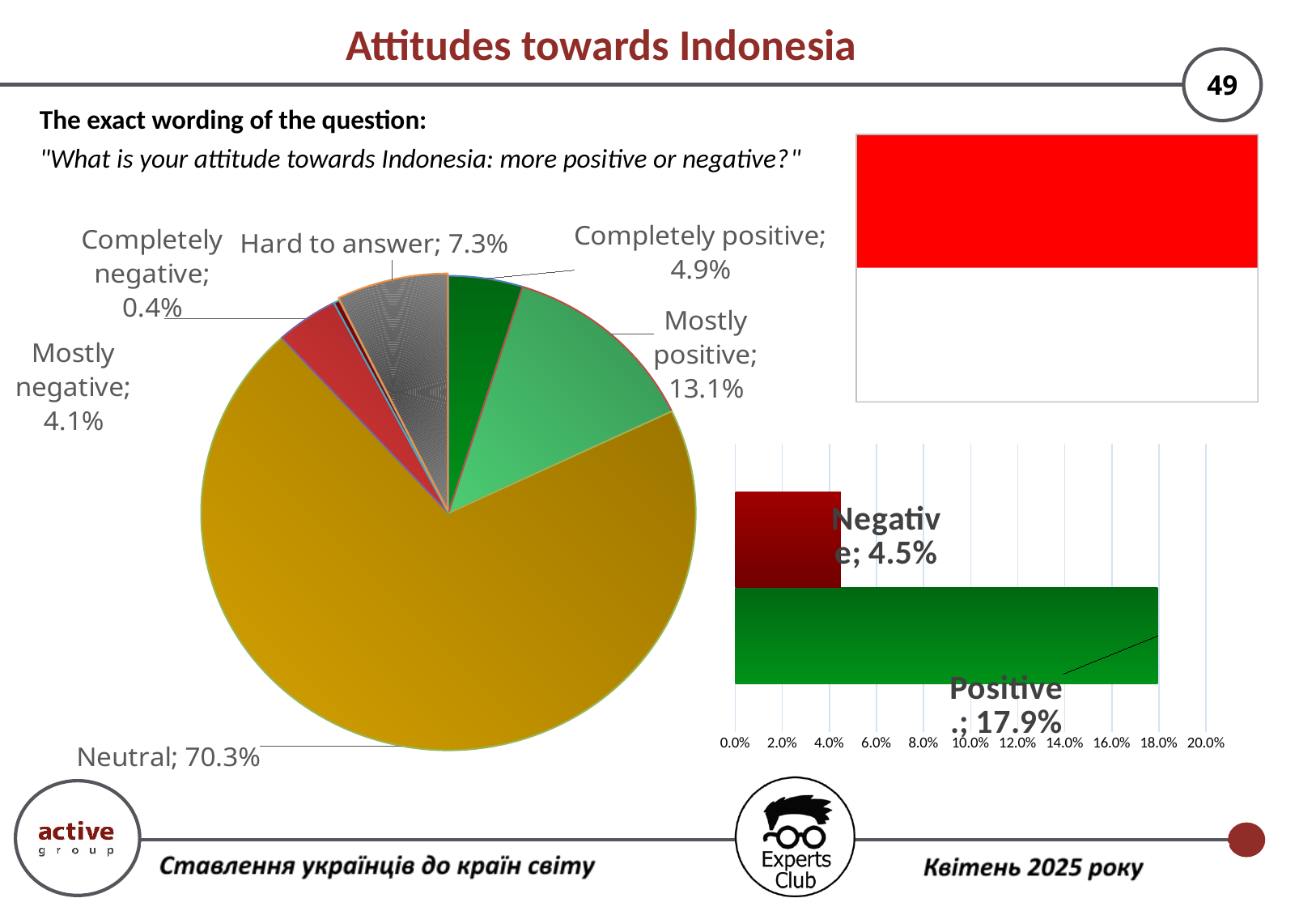
What type of chart is shown at the bottom right of the slide? Bar chart In the pie chart on the left, which category has the largest slice? Neutral In the bar chart on the right, what is the value for Positive? 17.9% In the bar chart on the right, what is the value for Negative? 4.5% In the pie chart on the left, what is the value for Hard to answer? 7.3% In the pie chart on the left, what is the difference between Mostly positive and Completely positive? 8.2% In the bar chart on the right, what is the difference between Positive and Negative? 13.4% In the pie chart on the left, what is the value for Mostly positive? 13.1% In the pie chart on the left, which is larger: Mostly negative or Completely positive? Completely positive In the pie chart on the left, how many slices are there? 6 In the pie chart on the left, which category has the smallest slice? Completely negative In the pie chart on the left, what share of respondents answered Neutral? 70.3%